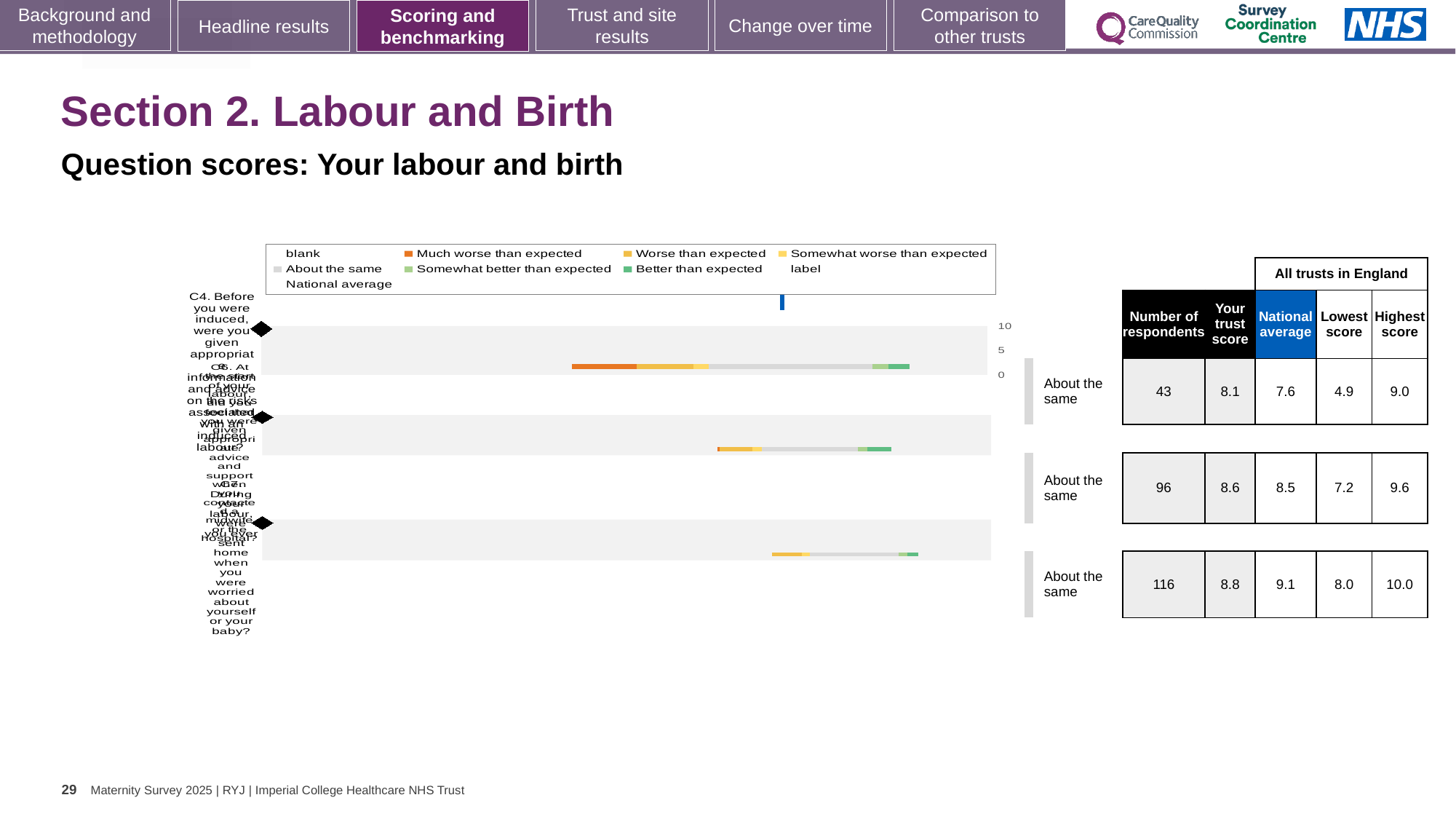
What colour represents 'Much worse than expected' in the chart legend? orange What kind of chart is shown on the slide? bar chart How many question rows (bars) are plotted in the chart? 3 In the table beside the chart, what is the national average for the third (bottom) question row? 9.1 In the table beside the chart, what is the trust score for the question row with 96 respondents? 8.6 Which question row has the largest number of respondents? the third (bottom) row, with 116 For the third (bottom) question row, what is the difference between the highest score and the lowest score? 2.0 For the second (middle) question row, how much higher is the trust score than the national average? 0.1 What benchmark label is shown next to each of the three question rows? About the same In the table beside the chart, what is the lowest score for the second (middle) question row? 7.2 In the table beside the chart, what is the number of respondents for the first (top) question row? 43 For the first (top) question row, which is larger: the trust score or the national average? trust score